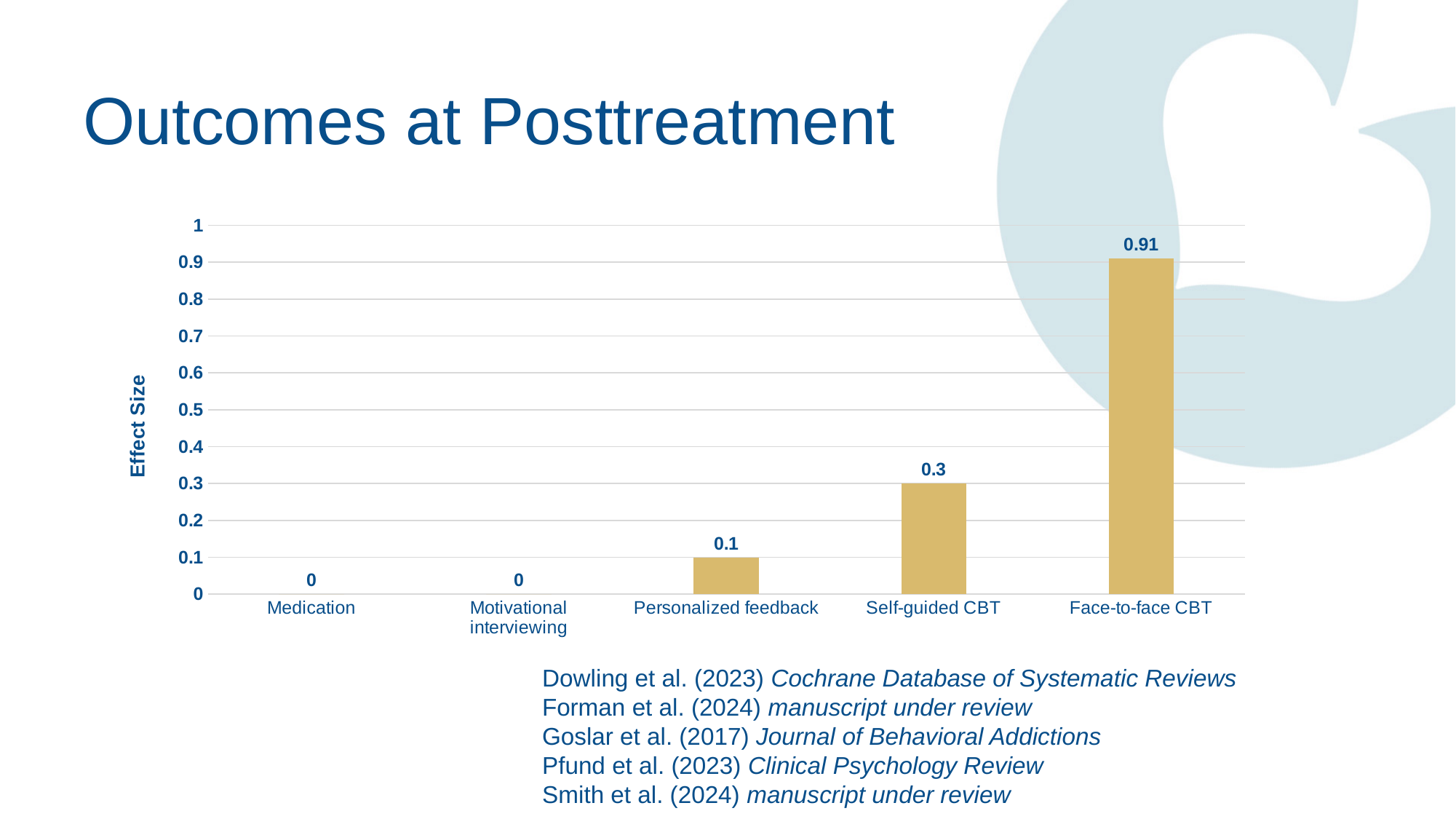
Is the effect size for Face-to-face CBT greater or less than 0.5? greater What kind of chart is shown on the slide? Bar chart What is the effect size for Medication? 0 What is the label of the y axis? Effect Size What is the effect size for Face-to-face CBT? 0.91 How many treatment categories are shown on the x axis? 5 What is the effect size for Self-guided CBT? 0.3 What is the effect size for Personalized feedback? 0.1 Which treatment has the highest effect size? Face-to-face CBT What is the difference in effect size between Self-guided CBT and Personalized feedback? 0.2 Which has a larger effect size, Personalized feedback or Self-guided CBT? Self-guided CBT What is the difference in effect size between Face-to-face CBT and Self-guided CBT? 0.61